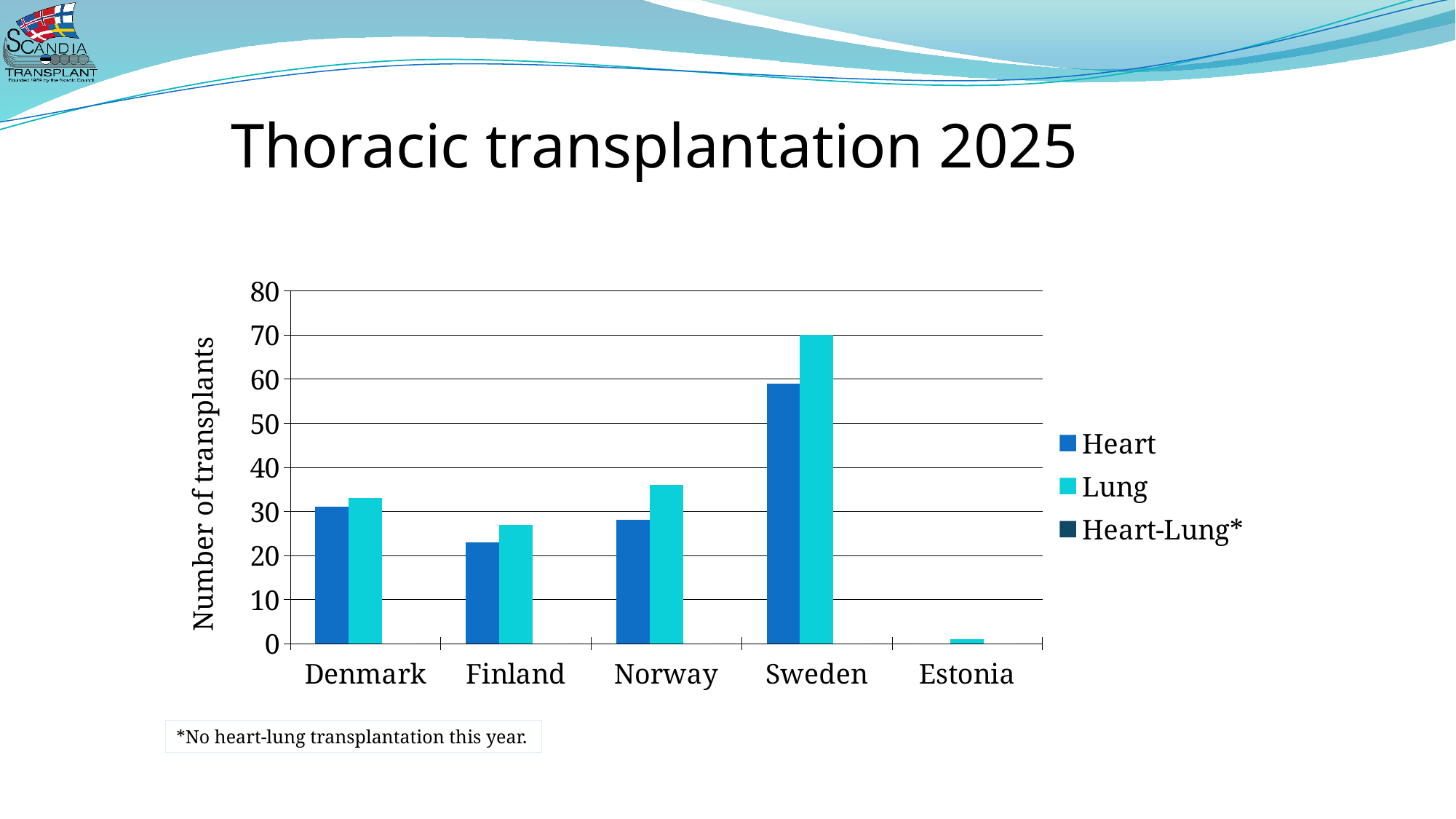
What kind of chart is shown on the slide? Bar chart What is the label of the y axis? Number of transplants For Norway, which is larger: heart transplants or lung transplants? Lung Is the value for Sweden's heart transplants greater or less than 50? greater Is the value for Norway's lung transplants greater or less than 40? less How many countries are shown on the x axis? 5 Is the value for Finland's heart transplants greater or less than 20? greater Which country has the highest number of lung transplants? Sweden Among Denmark, Finland, Norway and Sweden, which has the lowest number of heart transplants? Finland Which country has the lowest number of lung transplants? Estonia How many series does the legend list? 3 Which country has the highest number of heart transplants? Sweden